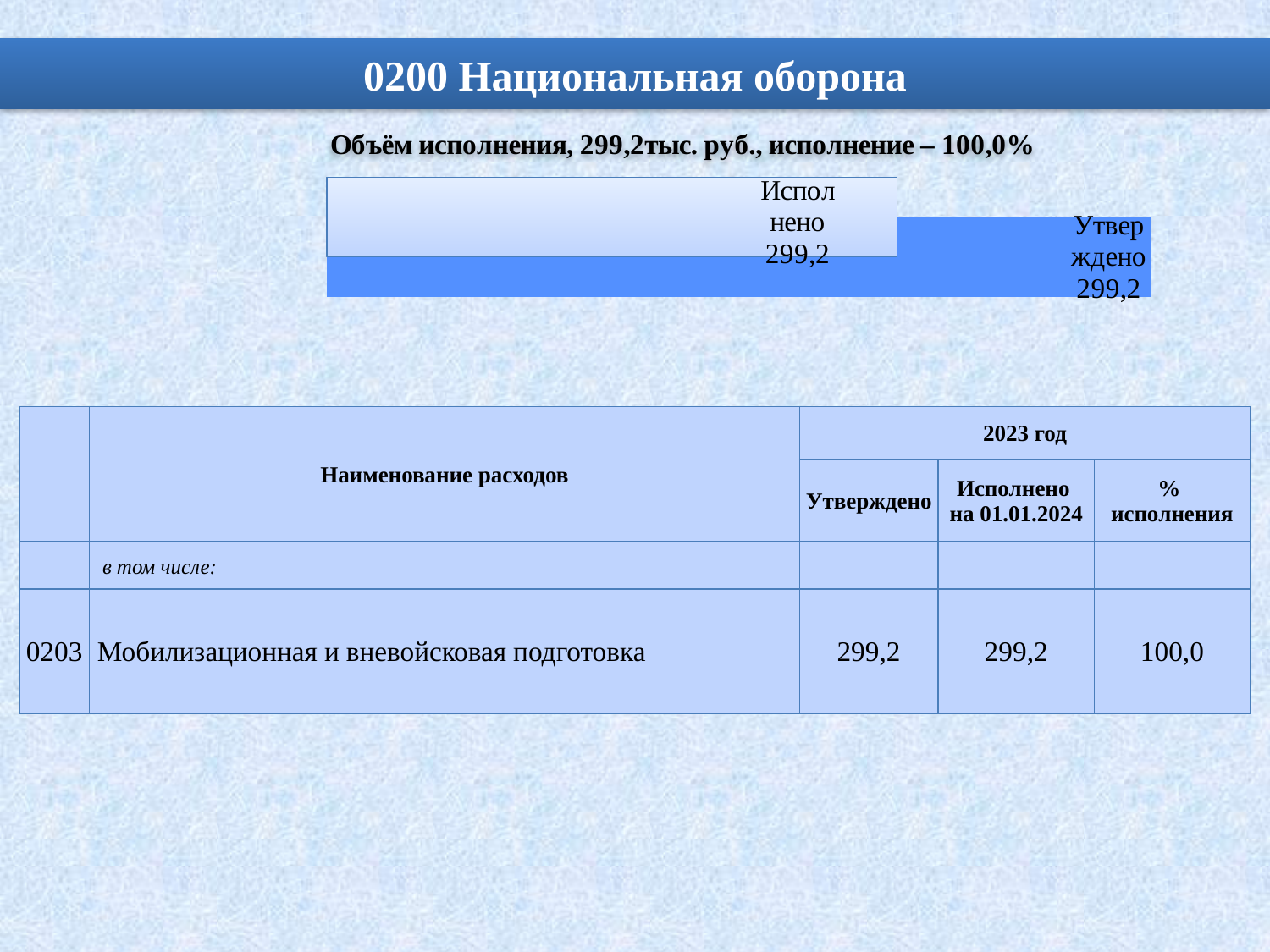
What is the execution percentage stated in the text above the chart? 100,0% What value is shown for the bar labelled Исполнено? 299,2 What is the difference between the Утверждено value and the Исполнено value? 0,0 What kind of chart is shown on the slide? bar chart What value is shown for the bar labelled Утверждено? 299,2 How many bars does the chart contain? 2 Are the bars in the chart horizontal or vertical? horizontal